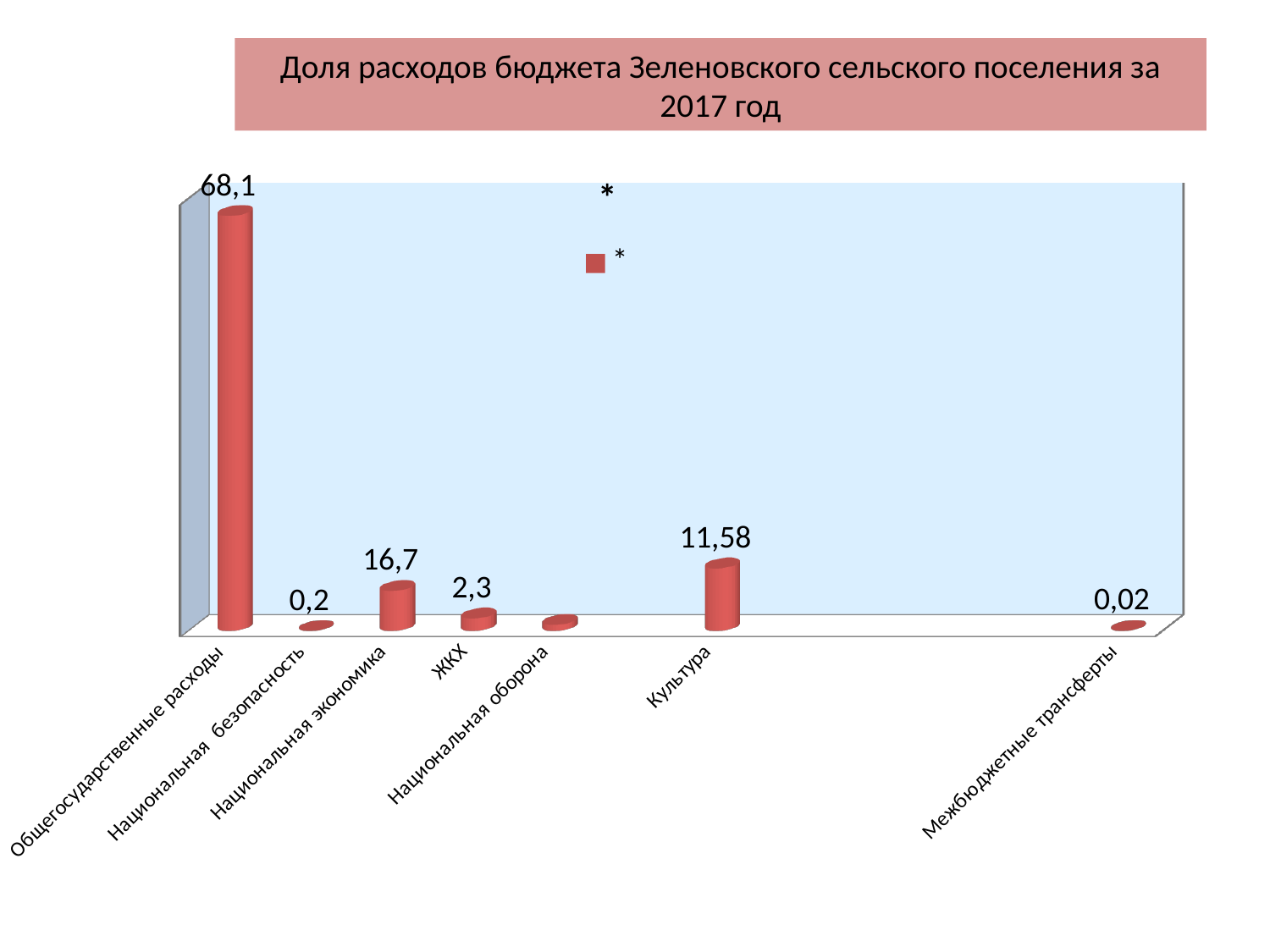
What is the difference between the values for Общегосударственные расходы and Национальная экономика? 51,4 What is the value for Межбюджетные трансферты? 0,02 What is the value for Национальная безопасность? 0,2 What is the value for Культура? 11,58 What is the value for ЖКХ? 2,3 Which category has the highest value? Общегосударственные расходы What is the title of the chart? Доля расходов бюджета Зеленовского сельского поселения за 2017 год What kind of chart is shown on the slide? Bar chart How many categories are shown on the x axis? 7 What is the value for Национальная экономика? 16,7 What is the value for Общегосударственные расходы? 68,1